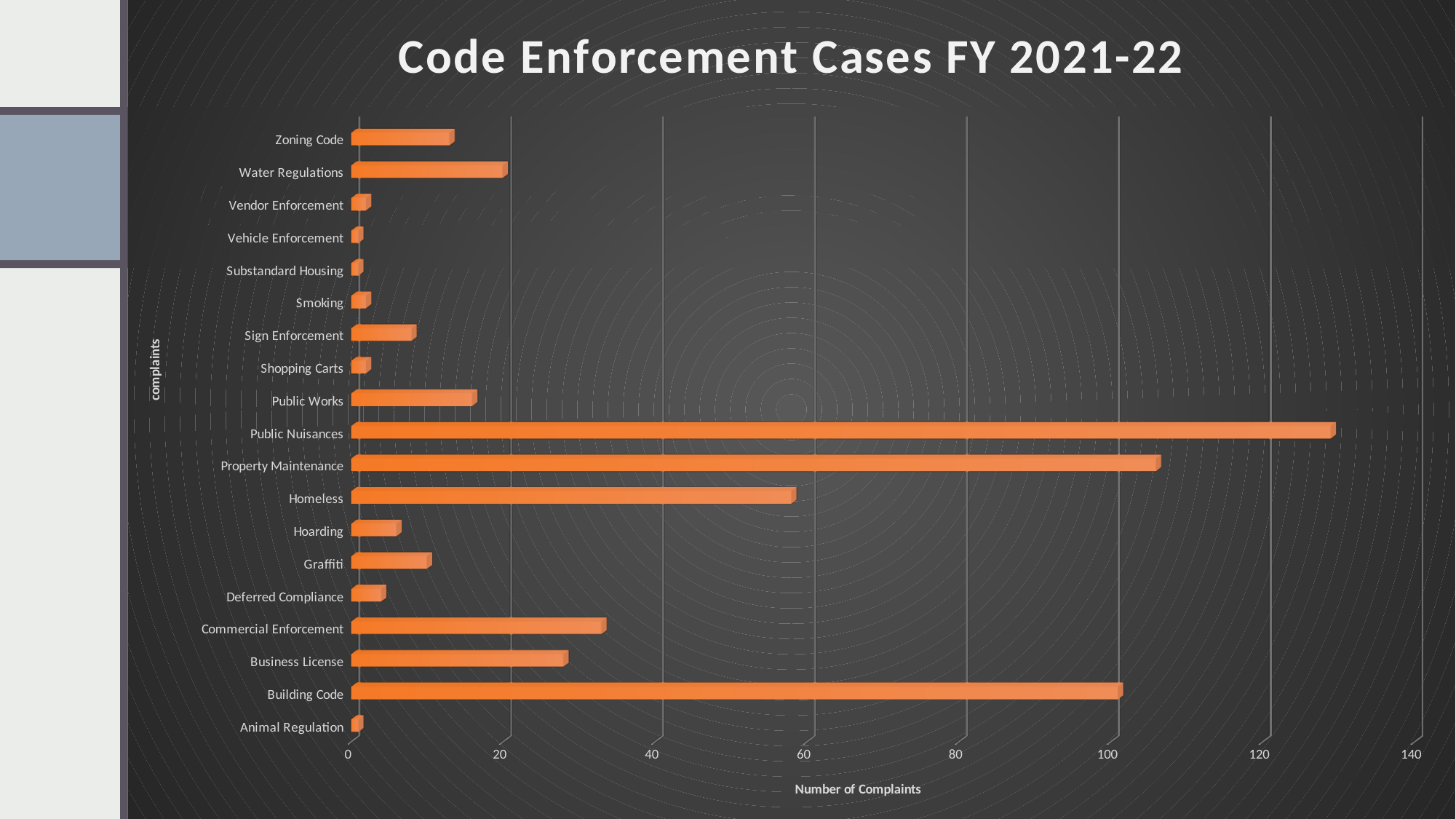
Is the value for Homeless greater or less than 60? less Is the value for Commercial Enforcement greater or less than 20? greater What is the title of the chart? Code Enforcement Cases FY 2021-22 How many categories are plotted in the chart? 19 What kind of chart is shown on the slide? bar chart Which has more complaints, Public Nuisances or Property Maintenance? Public Nuisances Is the value for Zoning Code greater or less than 20? less Which category has the highest number of complaints? Public Nuisances What is the label on the horizontal axis of the chart? Number of Complaints